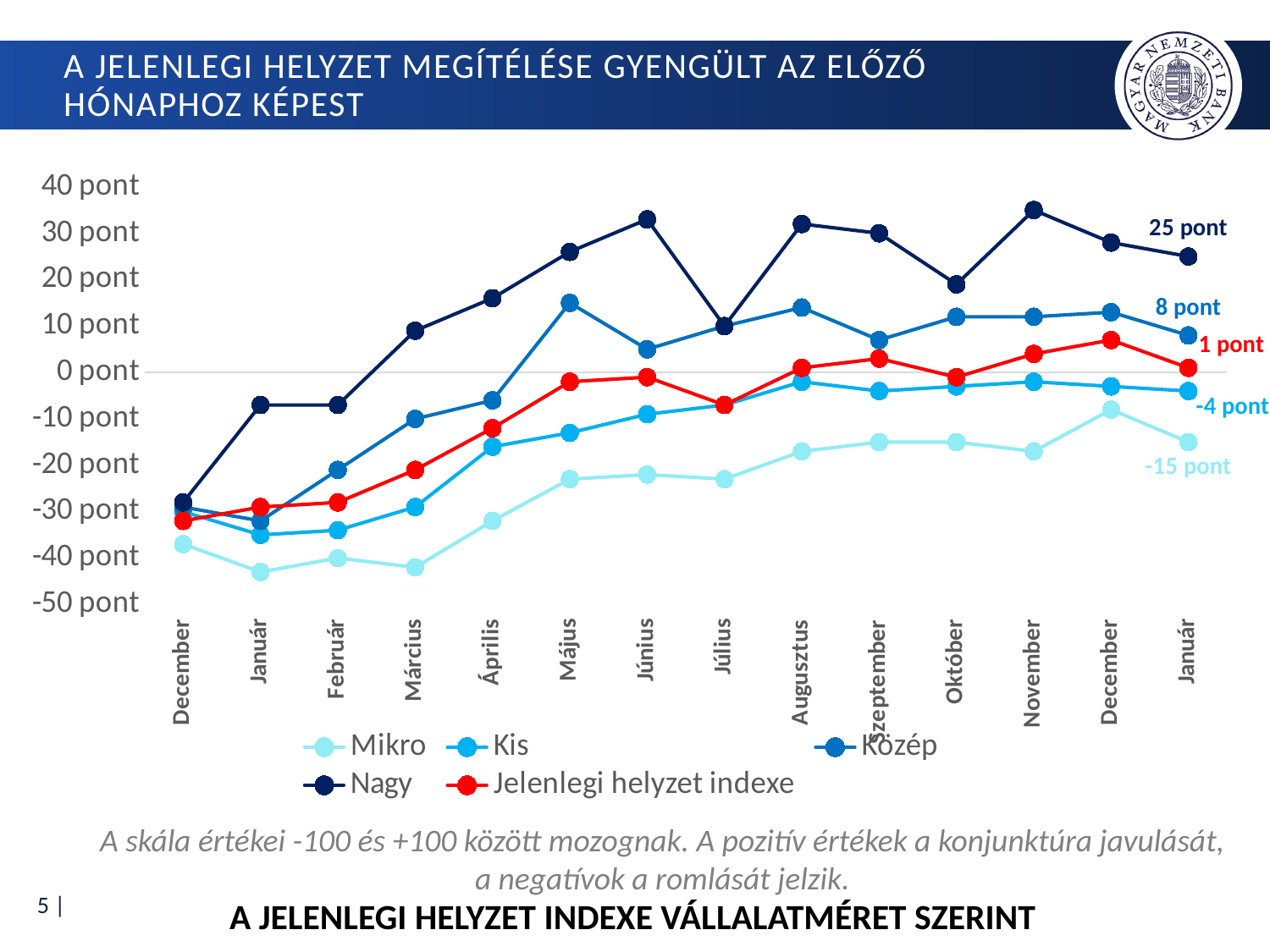
What is the value of the Jelenlegi helyzet indexe series at the final Január point? 1 pont How many series does the legend list? 5 Does the Mikro series overall rise or fall from the first December to the final Január? rise What is the value of the Közép series at the final Január point? 8 pont What is the value of the Mikro series at the final Január point? -15 pont What is the value of the Nagy series at the final Január point? 25 pont Which series has the highest value at the final Január point? Nagy At the final Január point, what is the difference between the Nagy and Közép values? 17 pont What is the value of the Kis series at the final Január point? -4 pont Is the value for Nagy in Június greater or less than 30 pont? greater What kind of chart is shown on the slide? line chart How many months are shown along the x axis? 14